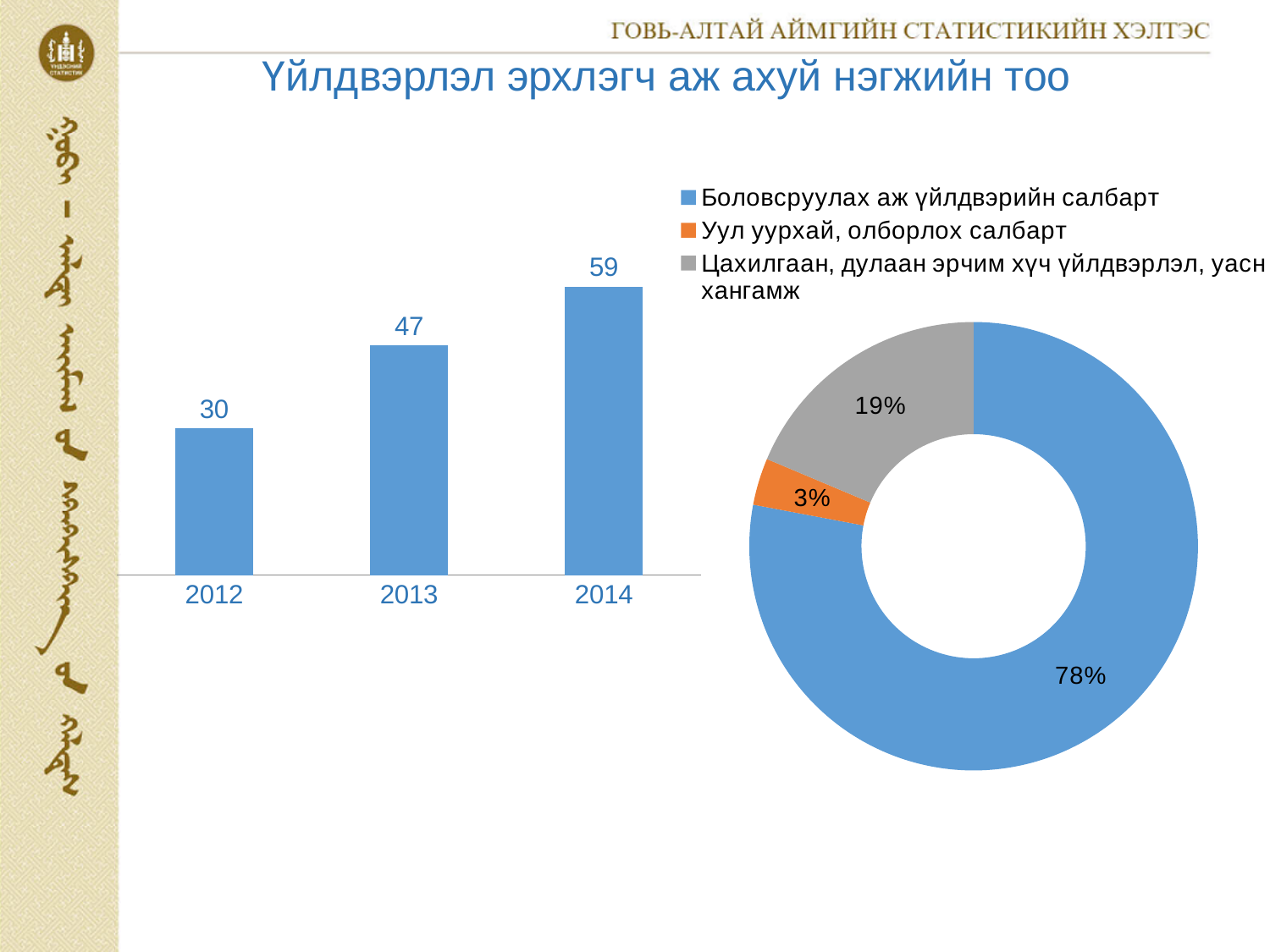
In the bar chart on the left, which year has the lowest value? 2012 In the bar chart on the left, what is the difference between the values for 2014 and 2012? 29 In the bar chart on the left, do the values rise or fall from 2012 to 2014? rise How many entries does the legend of the doughnut chart on the right list? 3 In the bar chart on the left, which year has the highest value? 2014 What kind of chart is on the left side of the slide? bar chart In the doughnut chart on the right, what share does the 'Боловсруулах аж үйлдвэрийн салбарт' slice have? 78% In the doughnut chart on the right, which colour is the 'Уул уурхай, олборлох салбарт' slice? orange In the bar chart on the left, what is the value for 2012? 30 In the doughnut chart on the right, what share does the 'Уул уурхай, олборлох салбарт' slice have? 3% In the bar chart on the left, what is the value for 2013? 47 How many bars are in the bar chart on the left? 3